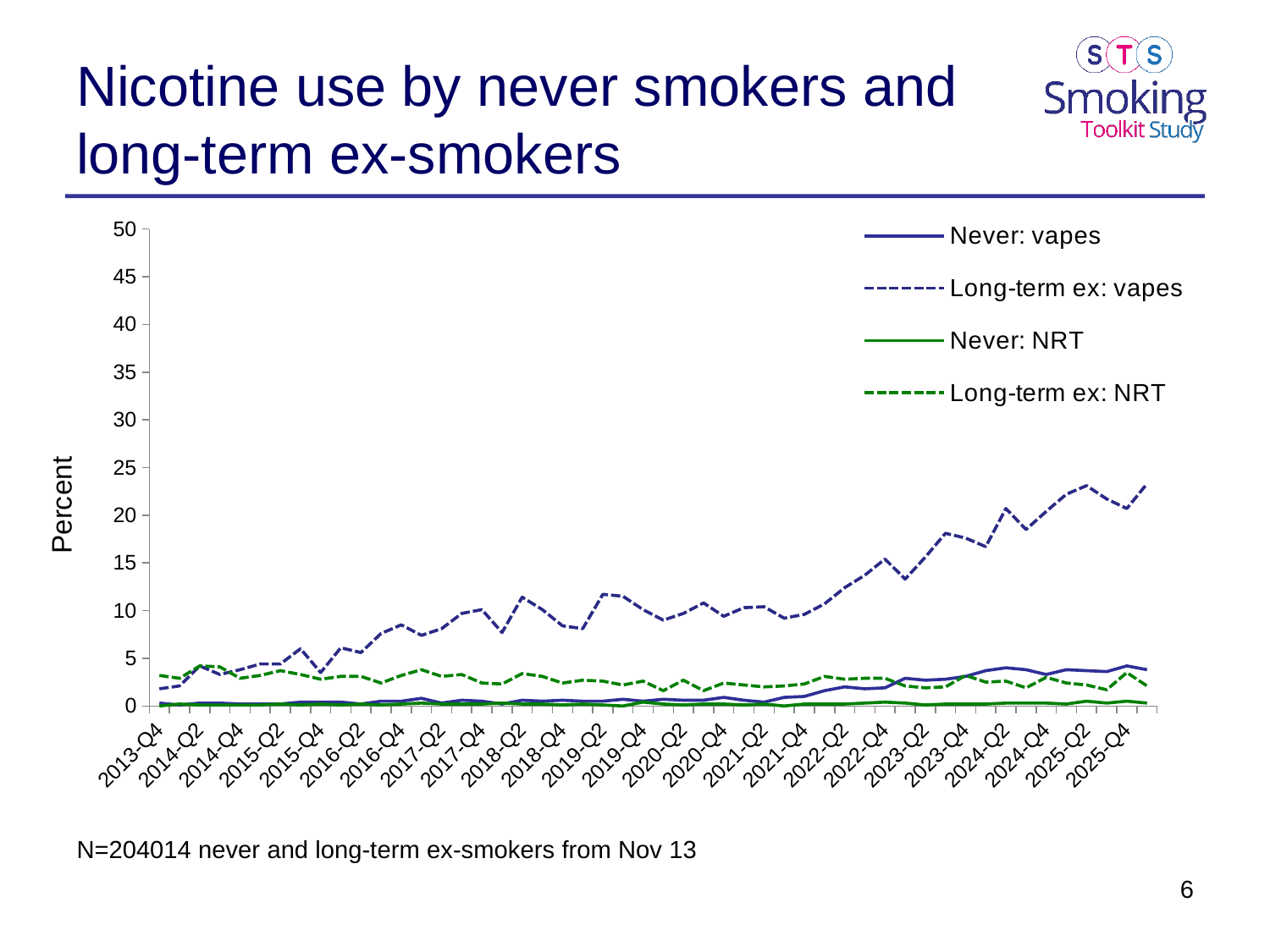
Is the value for Never: vapes at 2025-Q4 greater or less than 5? less How many series does the legend list? 4 What is the label on the y axis? Percent At 2025-Q4, which is larger: Long-term ex: vapes or Never: vapes? Long-term ex: vapes What kind of chart is shown on the slide? Line chart Is the value for Long-term ex: vapes at 2022-Q4 greater or less than 10? greater Which series stays lowest across the whole period? Never: NRT Does the Long-term ex: vapes series generally rise or fall from 2013-Q4 to 2025-Q4? Rise Is the value for Long-term ex: vapes at 2013-Q4 greater or less than 5? less Which series reaches the highest value on the chart? Long-term ex: vapes Which series is drawn as a dashed dark blue line? Long-term ex: vapes